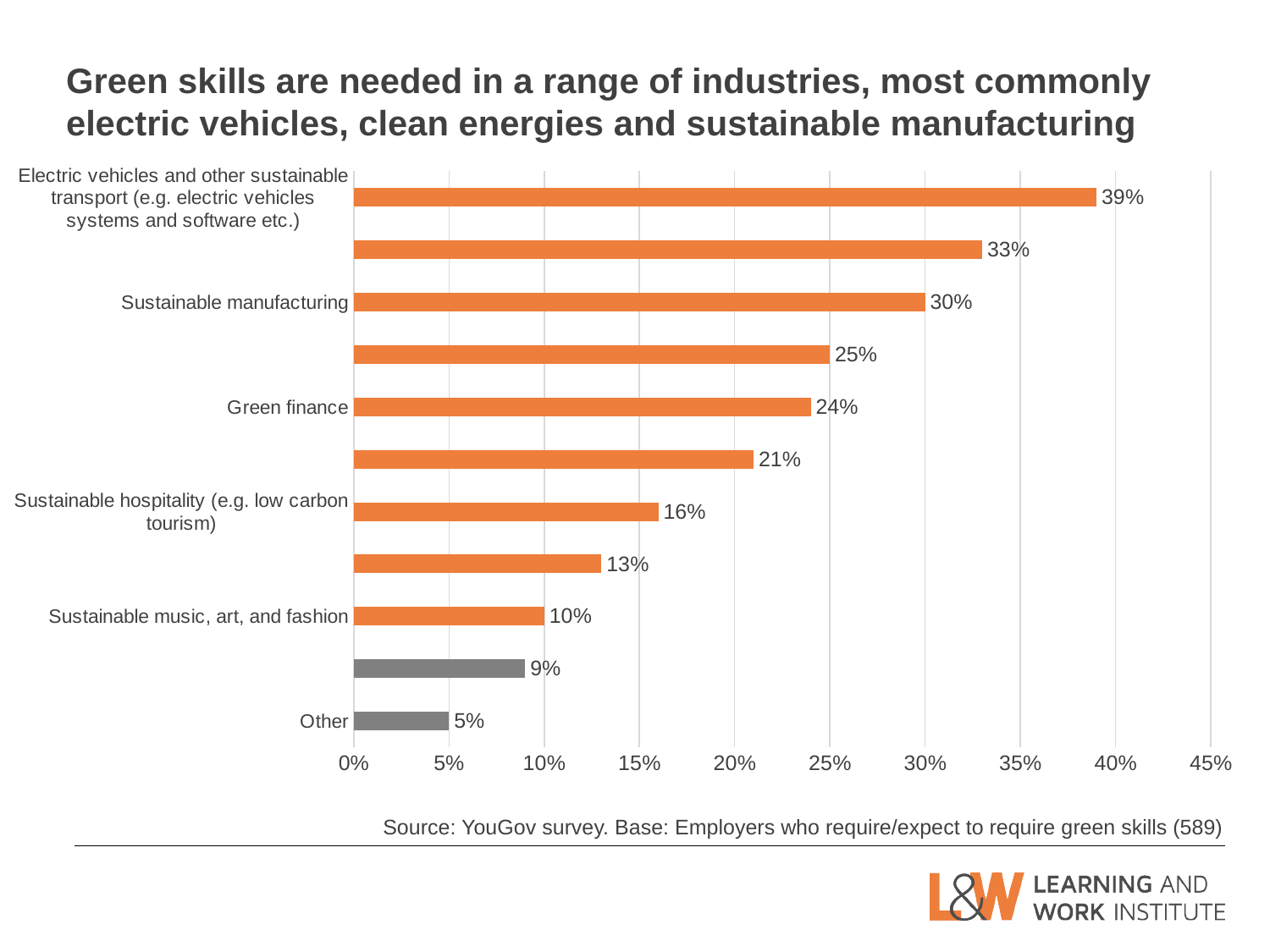
What is the value for Other? 5% What is the value for Sustainable manufacturing? 30% What is the value for Green finance? 24% How many bars are plotted on the chart? 11 What is the value for Electric vehicles and other sustainable transport? 39% What is the difference between the values for Sustainable manufacturing and Green finance? 6% What kind of chart is shown on the slide? Bar chart Which is larger, the value for Sustainable hospitality or the value for Sustainable music, art, and fashion? Sustainable hospitality What is the value for Sustainable music, art, and fashion? 10% Which category has the lowest value? Other What is the value for Sustainable hospitality (e.g. low carbon tourism)? 16% Which category has the highest value? Electric vehicles and other sustainable transport